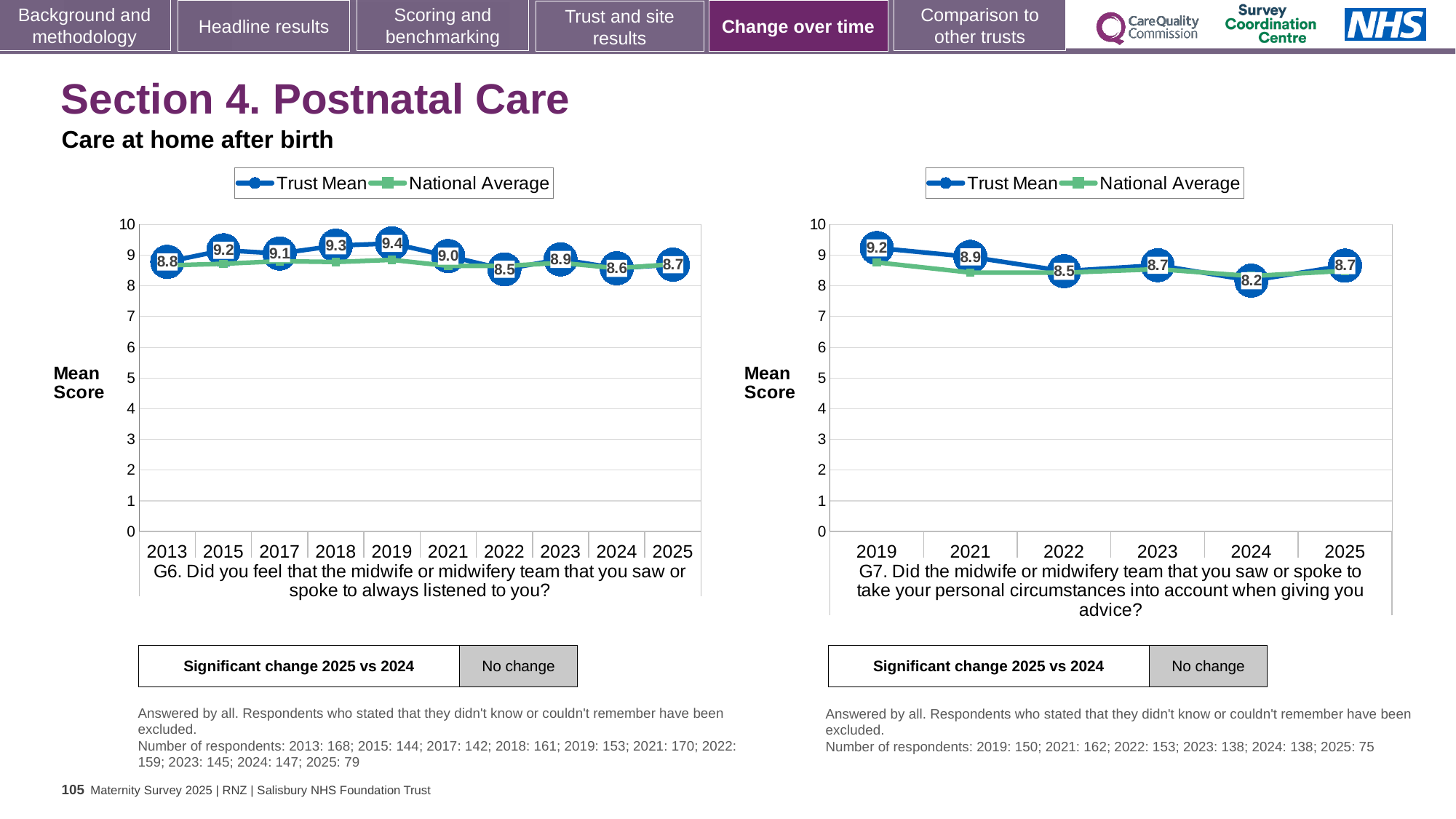
In the G7 chart on the right, does the Trust Mean score rise or fall from 2019 to 2024? Fall In the G7 chart on the right, what is the difference between the Trust Mean scores for 2019 and 2024? 1.0 In the G6 chart on the left, which year has the highest Trust Mean score? 2019 In the G7 chart on the right, which year has the lowest Trust Mean score? 2024 In the G6 chart on the left, which is larger: the Trust Mean score for 2018 or for 2021? 2018 In the G7 chart on the right, what is the Trust Mean score for 2024? 8.2 How many series does the legend of the G7 chart on the right list? 2 What type of chart is the G6 chart on the left? Line chart In the G6 chart on the left, which year has the lowest Trust Mean score? 2022 How many years are plotted in the G6 chart on the left? 10 In the G7 chart on the right, is the National Average value for 2024 greater or less than 9? less In the G6 chart on the left, what is the Trust Mean score for 2019? 9.4